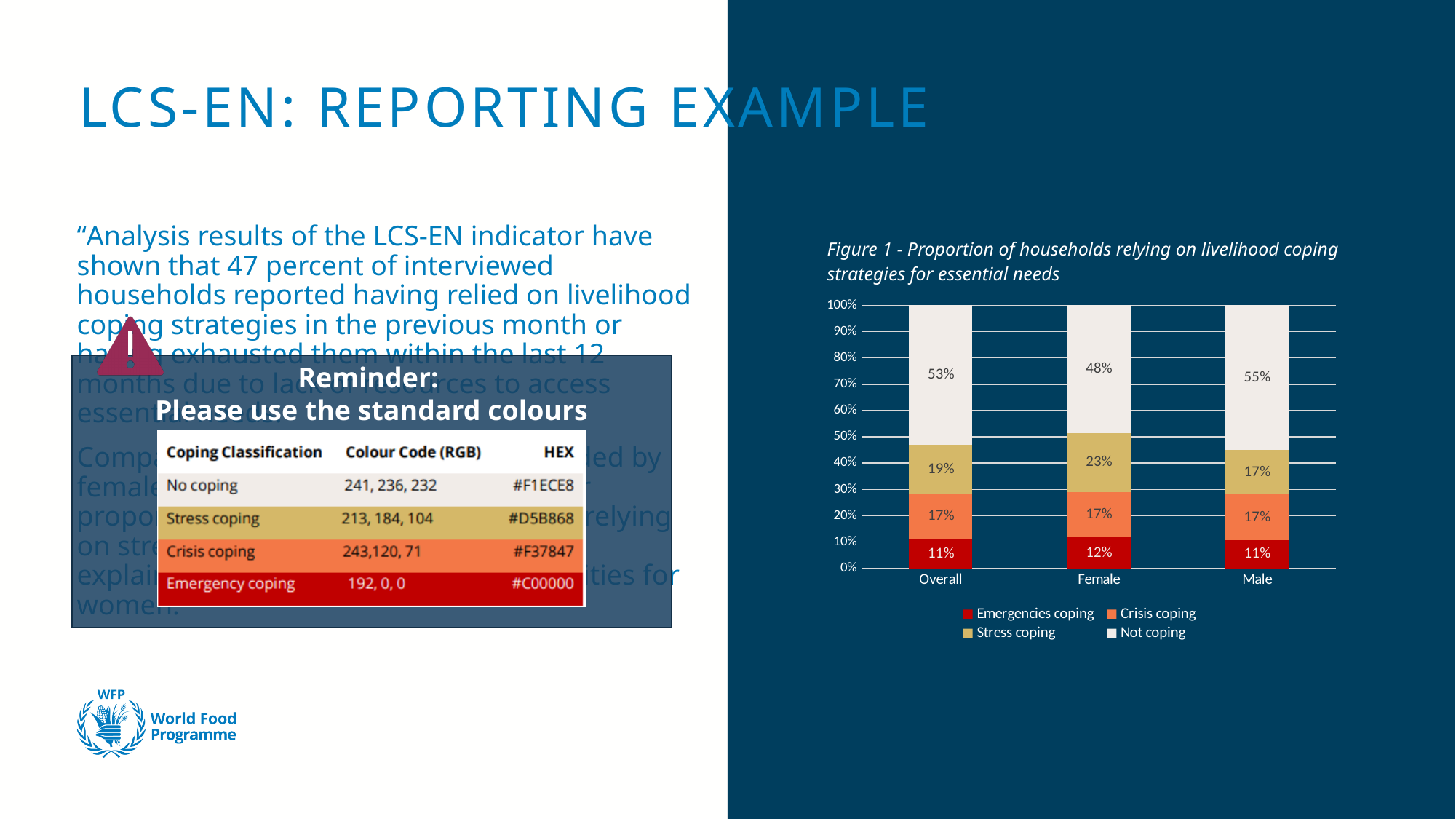
Which category has the highest Not coping value? Male What is the value for Stress coping in the Female bar? 23% What is the difference between the Stress coping values for Female and Male? 6% Which category has the lowest Not coping value? Female How many categories are shown on the x axis? 3 Is the Not coping value larger for Female or for Male? Male What is the value for Not coping in the Overall bar? 53% What kind of chart is shown? Stacked bar chart How many series does the legend list? 4 What is the title of the figure? Figure 1 - Proportion of households relying on livelihood coping strategies for essential needs What is the value for Emergencies coping in the Male bar? 11% What is the value for Crisis coping in the Female bar? 17%